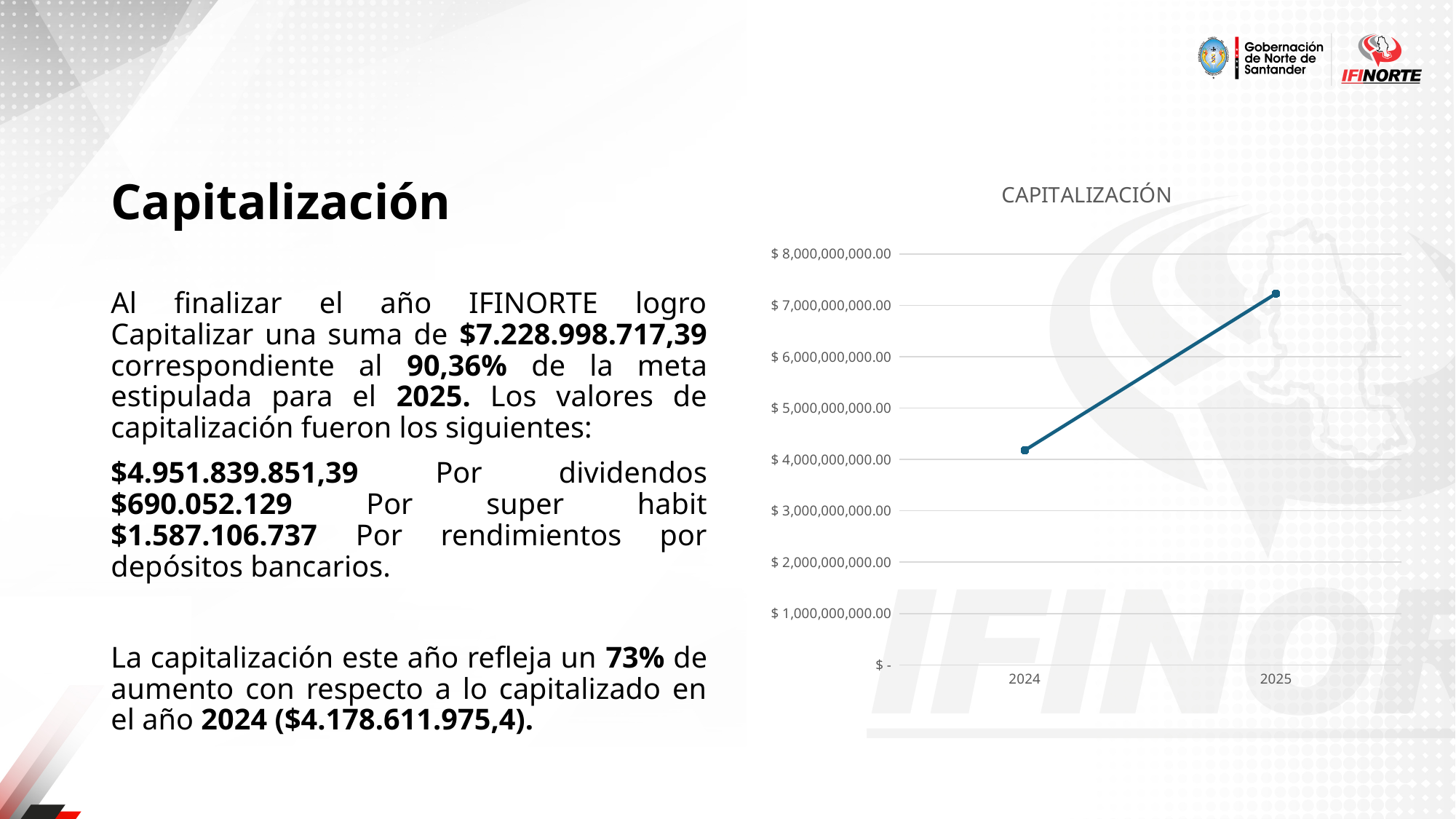
What is the title of the chart? CAPITALIZACIÓN How many data points are plotted on the chart? 2 What is the highest value shown on the vertical axis of the chart? $ 8,000,000,000.00 Which year has the lower capitalization value on the chart? 2024 Which year has the higher capitalization value on the chart? 2025 Does the capitalization value rise or fall from 2024 to 2025? rise Is the value for 2025 larger or smaller than the value for 2024? larger Is the value for 2025 greater or less than $ 8,000,000,000.00? less Is the value for 2025 greater or less than $ 7,000,000,000.00? greater Is the value for 2024 greater or less than $ 5,000,000,000.00? less What kind of chart is shown on the slide? line chart